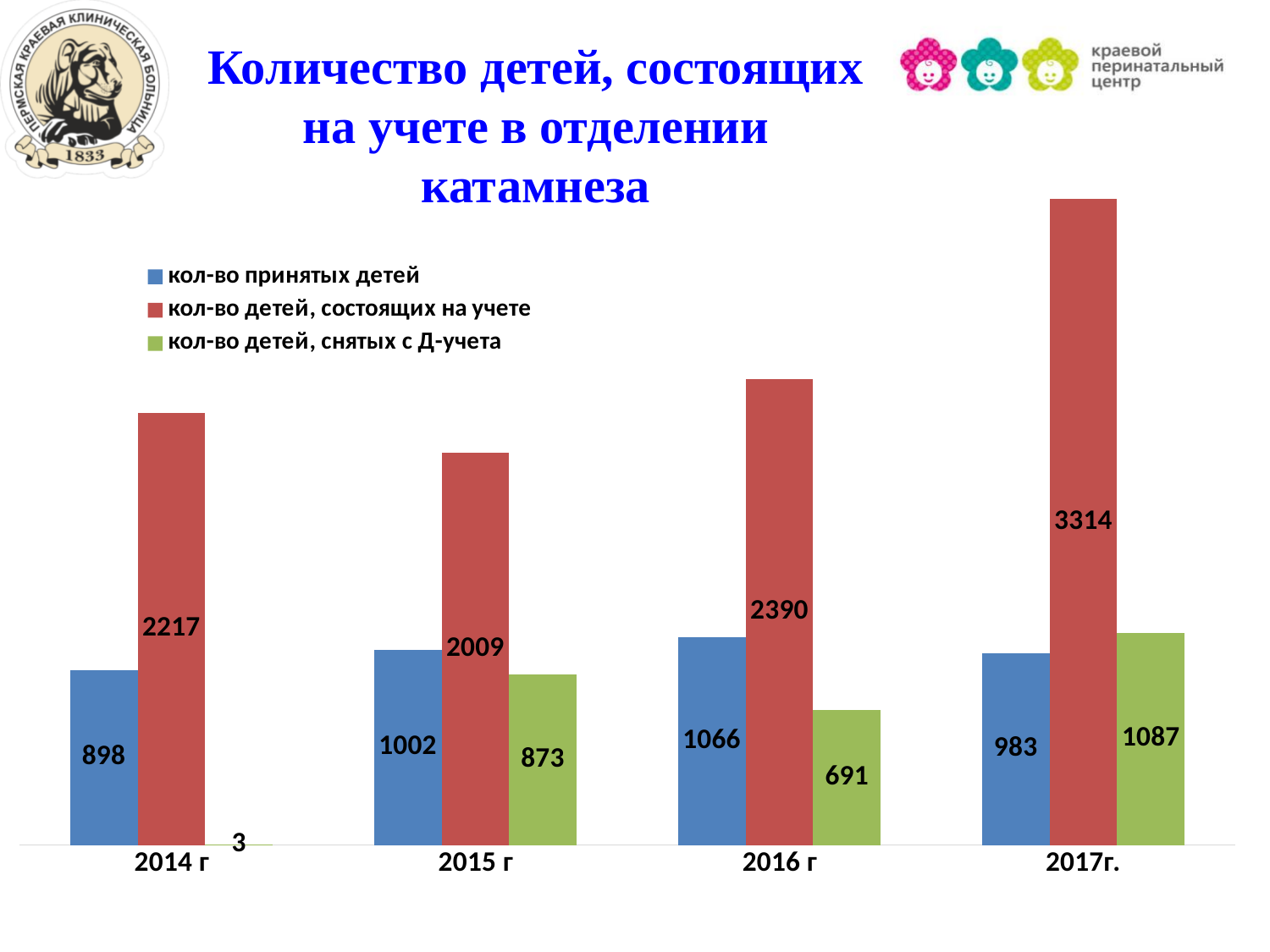
What kind of chart is shown on the slide? Bar chart Which colour represents "кол-во детей, состоящих на учете" in the chart? Red In which year is "кол-во детей, состоящих на учете" highest? 2017г. What is the value for "кол-во принятых детей" in 2014 г? 898 How many years are shown on the x axis? 4 How many series does the legend list? 3 What is the value for "кол-во детей, снятых с Д-учета" in 2014 г? 3 Which is larger: "кол-во принятых детей" in 2016 г or in 2017г.? 2016 г What is the difference between "кол-во детей, состоящих на учете" in 2017г. and in 2016 г? 924 In which year is "кол-во детей, снятых с Д-учета" lowest? 2014 г What is the value for "кол-во детей, снятых с Д-учета" in 2015 г? 873 What is the value for "кол-во детей, состоящих на учете" in 2017г.? 3314